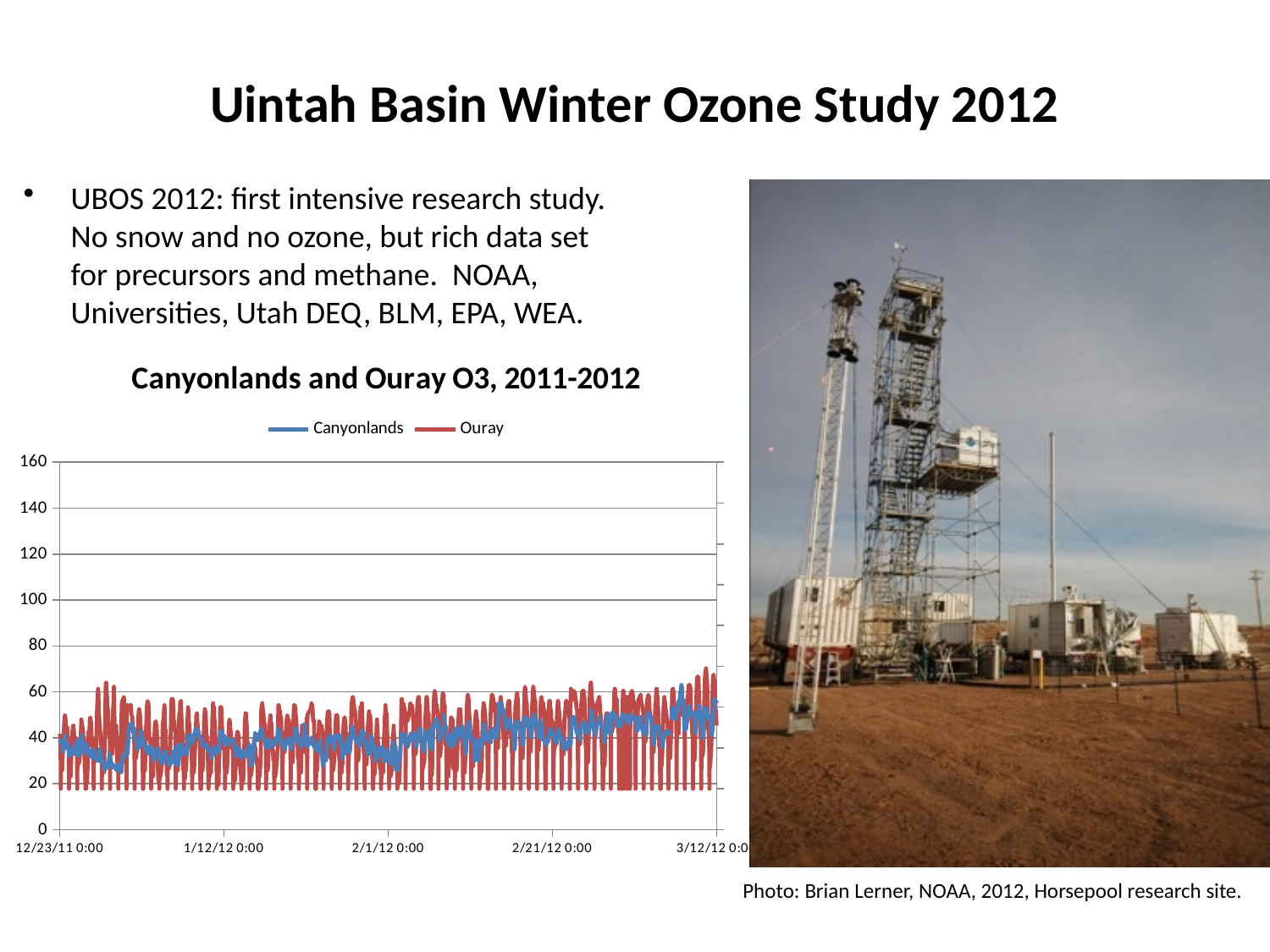
What is the highest value shown on the y axis of the chart? 160 Which series shows the larger daily swings between high and low values? Ouray Does the Canyonlands series generally rise or fall from the start to the end of the period shown? rise Is the highest value plotted for Ouray greater or less than 100? less How many date labels are shown along the x axis of the chart? 5 Is the highest value plotted for Canyonlands greater or less than 80? less Which series in the chart is drawn in red? Ouray What is the title of the chart? Canyonlands and Ouray O3, 2011-2012 What kind of chart is shown on the slide? line chart Is the lowest value plotted for Ouray greater or less than 40? less Which series reaches higher peak values, Canyonlands or Ouray? Ouray How many series does the legend of the chart list? 2